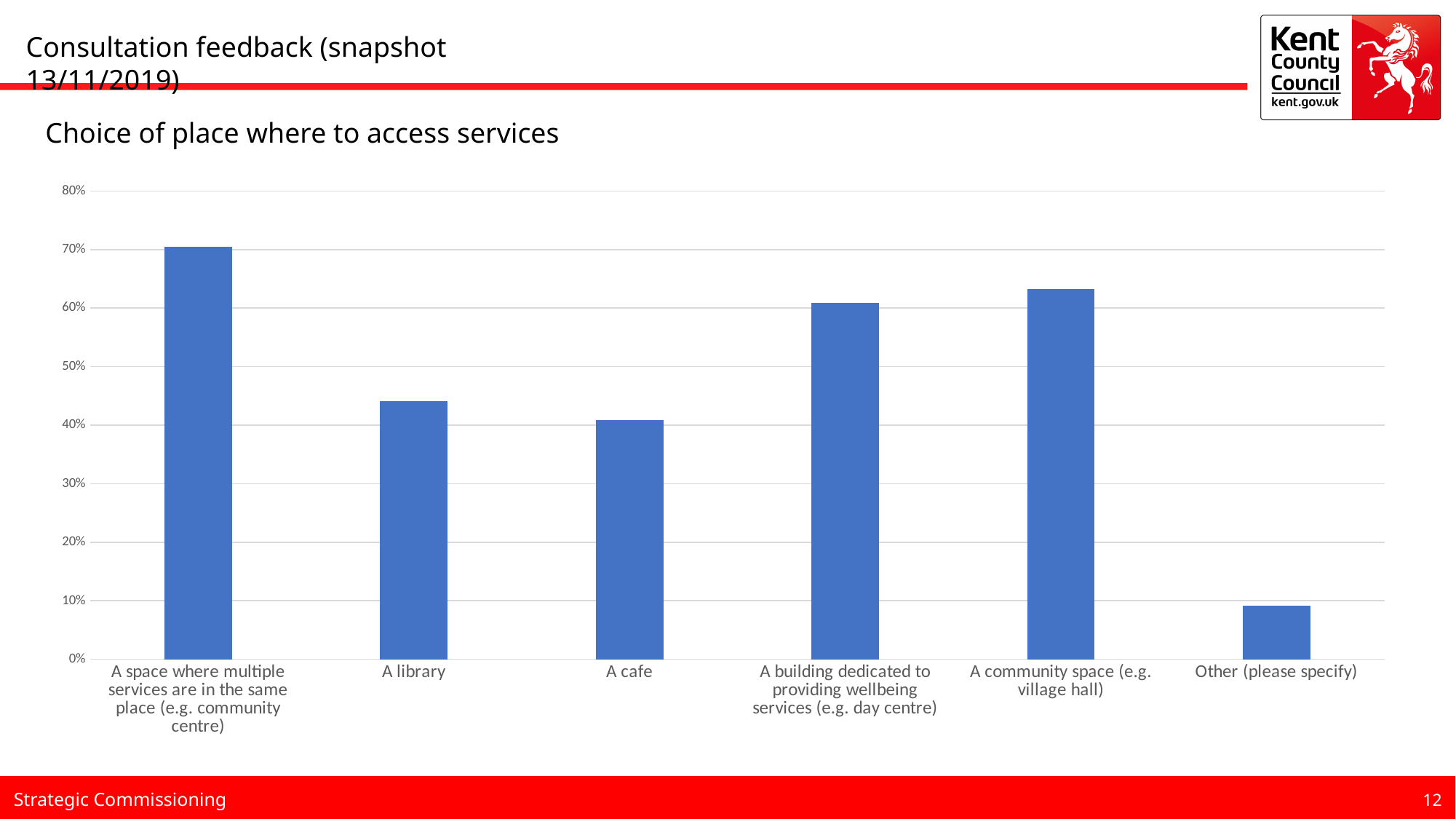
Which has a larger value, 'A cafe' or 'Other (please specify)'? A cafe Is the value for 'A space where multiple services are in the same place (e.g. community centre)' greater or less than 60%? greater What is the title of the chart on the slide? Choice of place where to access services How many categories are shown on the x axis of the chart? 6 Which category has the lowest value in the chart? Other (please specify) Which has a larger value, 'A library' or 'A community space (e.g. village hall)'? A community space (e.g. village hall) Is the value for 'A building dedicated to providing wellbeing services (e.g. day centre)' greater or less than 50%? greater Which category has the highest value in the chart? A space where multiple services are in the same place (e.g. community centre) Is the value for 'A library' greater or less than 50%? less What kind of chart is shown on the slide? bar chart